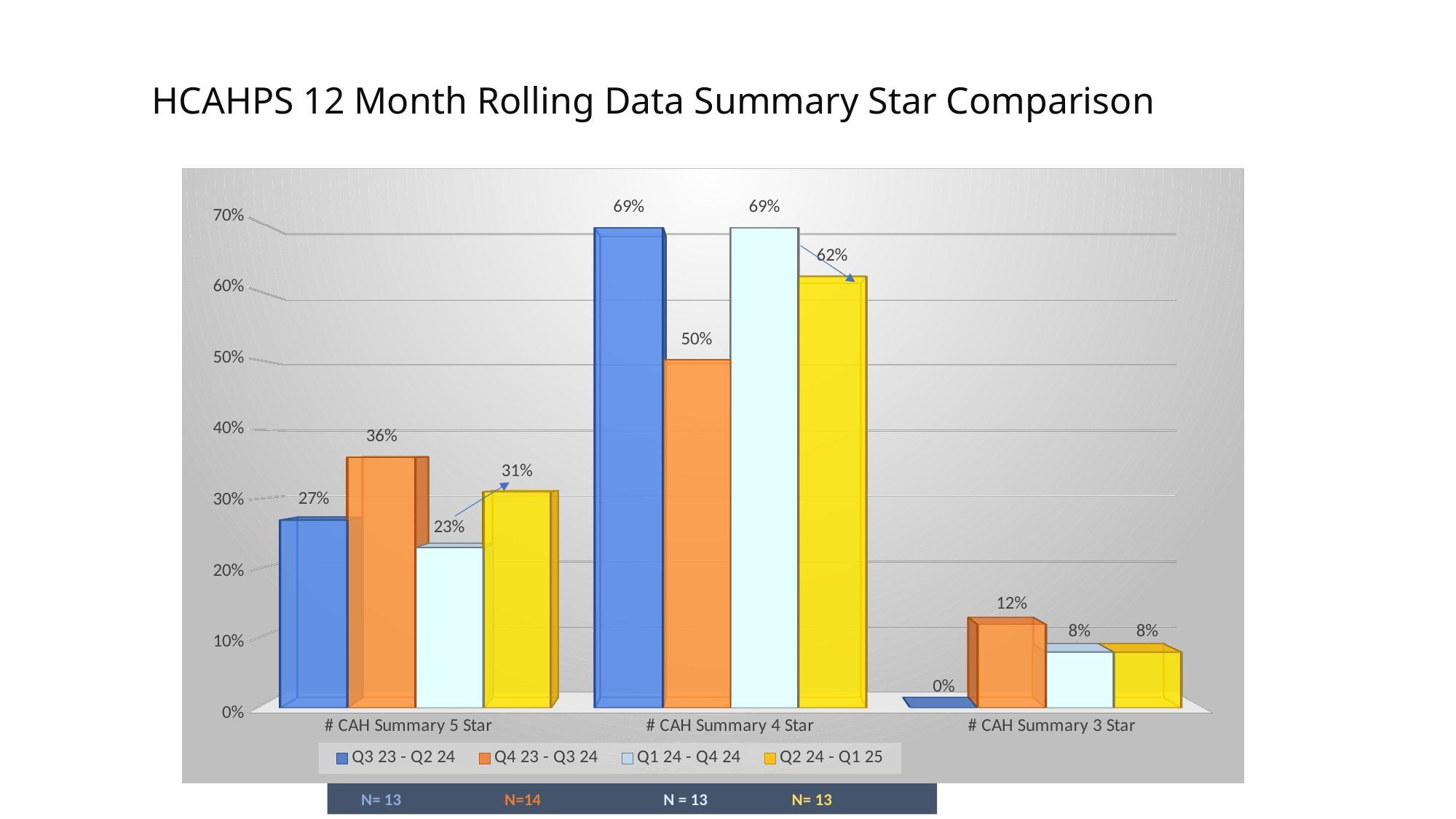
What is the value for Q3 23 - Q2 24 in the # CAH Summary 5 Star category? 27% Which series has the lowest value in the # CAH Summary 5 Star category? Q1 24 - Q4 24 How many categories are shown on the x axis? 3 What is the value for Q1 24 - Q4 24 in the # CAH Summary 5 Star category? 23% What is the difference between the Q4 23 - Q3 24 and Q2 24 - Q1 25 values in the # CAH Summary 5 Star category? 5% Which is larger in the # CAH Summary 4 Star category: Q4 23 - Q3 24 or Q2 24 - Q1 25? Q2 24 - Q1 25 What is the value for Q4 23 - Q3 24 in the # CAH Summary 4 Star category? 50% What kind of chart is shown on the slide? Bar chart What is the value for Q2 24 - Q1 25 in the # CAH Summary 3 Star category? 8% How many series does the legend list? 4 What is the title of the chart? HCAHPS 12 Month Rolling Data Summary Star Comparison Which series has the highest value in the # CAH Summary 3 Star category? Q4 23 - Q3 24